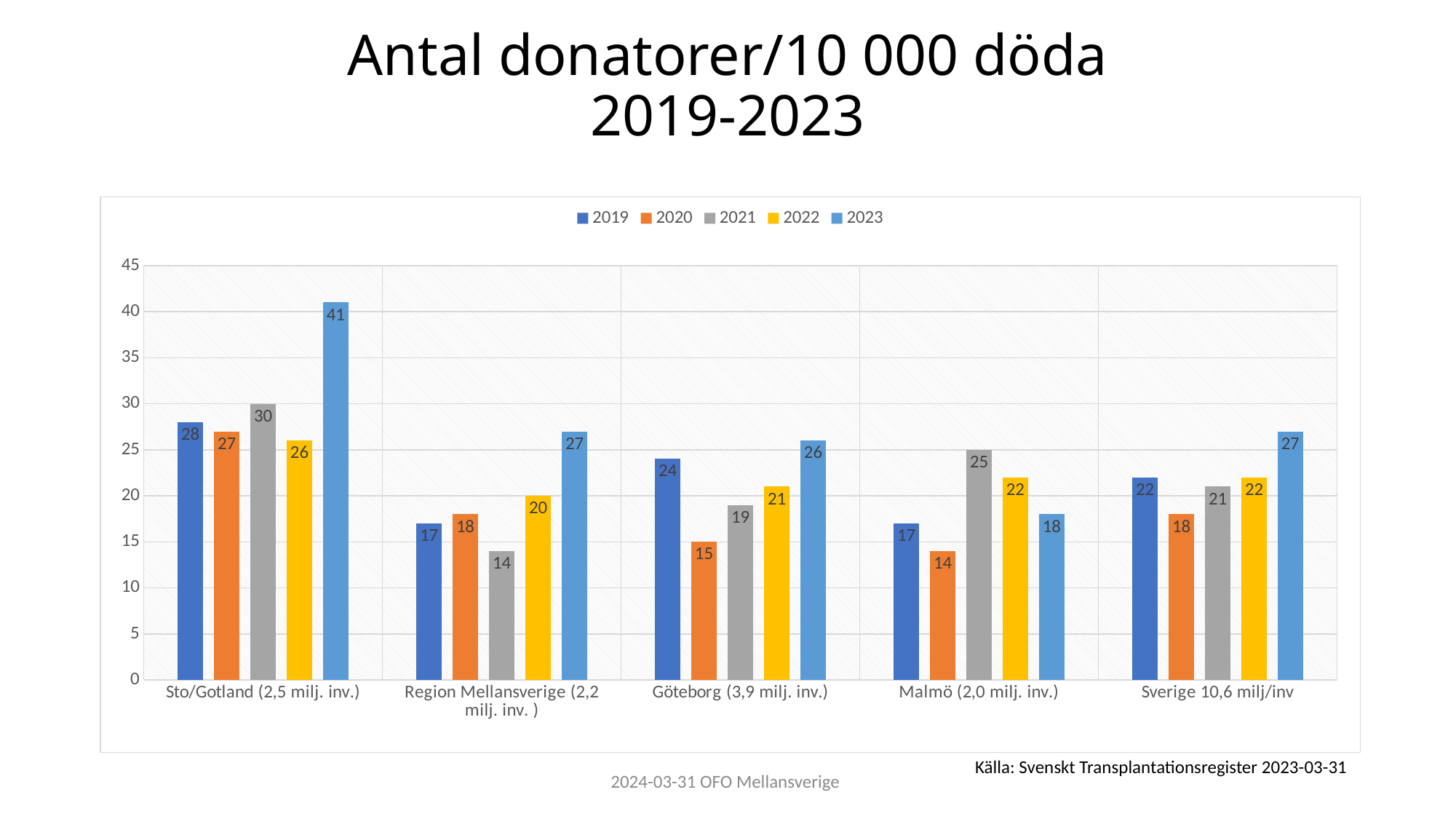
What kind of chart is shown on the slide? bar chart How many categories are shown on the x axis? 5 How many series does the legend list? 5 What is the title of the chart? Antal donatorer/10 000 döda 2019-2023 What is the value for 2020 in Göteborg (3,9 milj. inv.)? 15 What is the value for 2021 in Malmö (2,0 milj. inv.)? 25 What is the difference between the 2023 and 2019 values for Sto/Gotland (2,5 milj. inv.)? 13 Is the value for 2023 in Sto/Gotland (2,5 milj. inv.) greater or less than 40? greater Which category has the highest value for the 2023 series? Sto/Gotland (2,5 milj. inv.) Which is larger in Malmö (2,0 milj. inv.): the 2021 value or the 2023 value? 2021 What is the value for 2023 in Sto/Gotland (2,5 milj. inv.)? 41 Which category has the lowest value for the 2021 series? Region Mellansverige (2,2 milj. inv. )